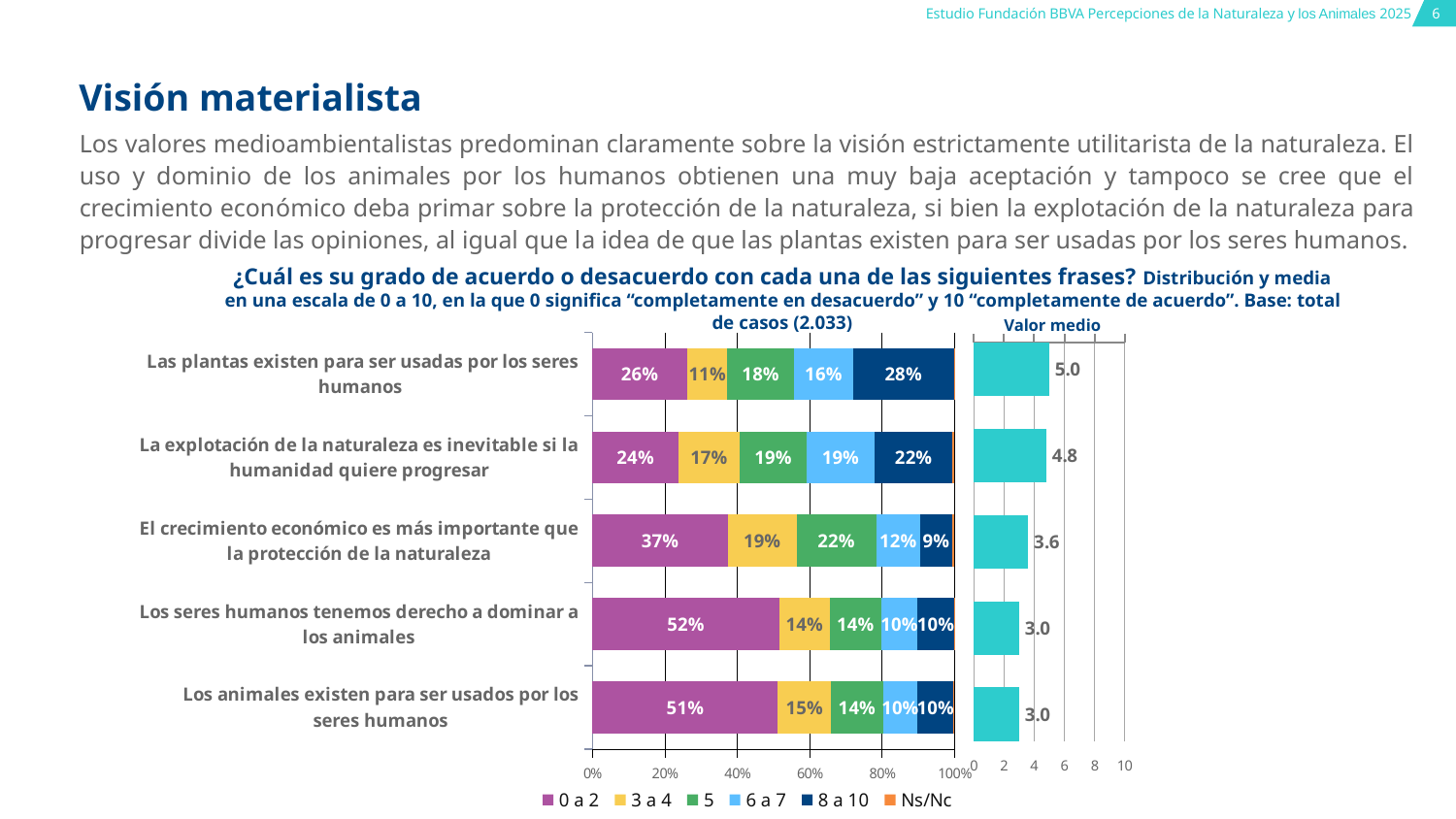
In the stacked distribution chart, which statement has the highest percentage in the 3 a 4 category? El crecimiento económico es más importante que la protección de la naturaleza How many statements are shown in the stacked distribution chart? 5 In the Valor medio chart, what is the difference between the mean for "Las plantas existen para ser usadas por los seres humanos" and the mean for "El crecimiento económico es más importante que la protección de la naturaleza"? 1.4 In the stacked distribution chart, what percentage gave 8 a 10 for "Las plantas existen para ser usadas por los seres humanos"? 28% In the Valor medio chart, what is the mean value for "La explotación de la naturaleza es inevitable si la humanidad quiere progresar"? 4.8 In the stacked distribution chart, which statement has the lowest percentage in the 8 a 10 category? El crecimiento económico es más importante que la protección de la naturaleza What kind of chart is the distribution chart on the left? Stacked horizontal bar chart In the stacked distribution chart, what percentage of respondents gave a score of 0 a 2 for "Los seres humanos tenemos derecho a dominar a los animales"? 52% In the stacked distribution chart, which statement has a larger share in the 5 category: "El crecimiento económico es más importante que la protección de la naturaleza" or "Las plantas existen para ser usadas por los seres humanos"? El crecimiento económico es más importante que la protección de la naturaleza How many series does the legend of the stacked distribution chart list? 6 In the Valor medio chart, which statement has the highest mean value? Las plantas existen para ser usadas por los seres humanos In the stacked distribution chart, what is the difference in the 8 a 10 percentage between "Las plantas existen para ser usadas por los seres humanos" and "La explotación de la naturaleza es inevitable si la humanidad quiere progresar"? 6 percentage points